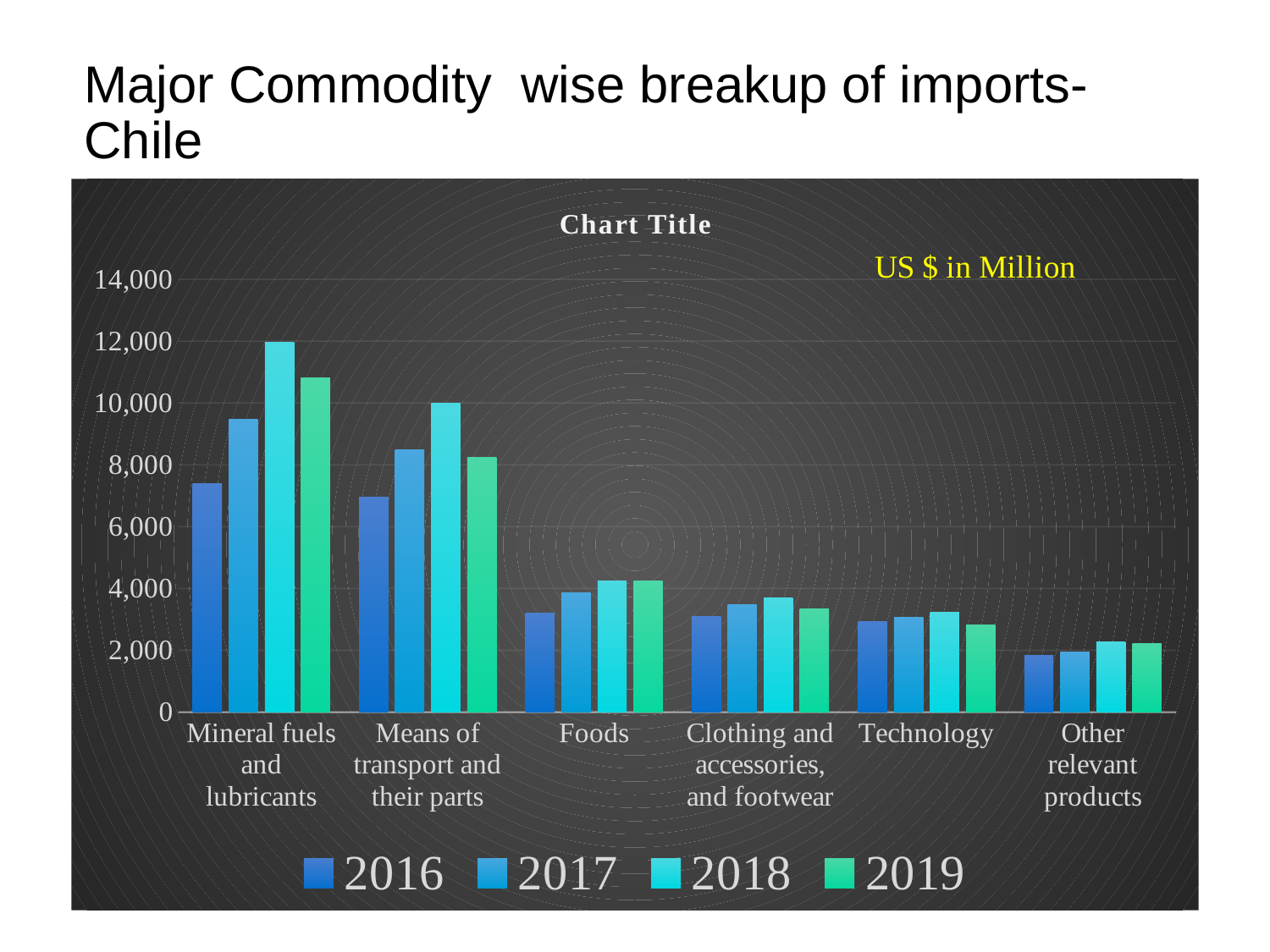
How many commodity categories are shown on the x axis? 6 For 2019, which is larger: Foods or Technology? Foods Is the 2017 value for Mineral fuels and lubricants greater or less than 8,000? greater Is the 2016 value for Foods greater or less than 4,000? less What unit is stated for the values in the chart? US $ in Million Which commodity category has the lowest value for 2016? Other relevant products Is the 2016 value for Means of transport and their parts greater or less than 6,000? greater How many series does the legend list? 4 For Mineral fuels and lubricants, do the values rise or fall from 2016 to 2018? Rise Which commodity category has the highest value for 2018? Mineral fuels and lubricants What kind of chart is shown on the slide? Bar chart For 2018, which is larger: Mineral fuels and lubricants or Means of transport and their parts? Mineral fuels and lubricants